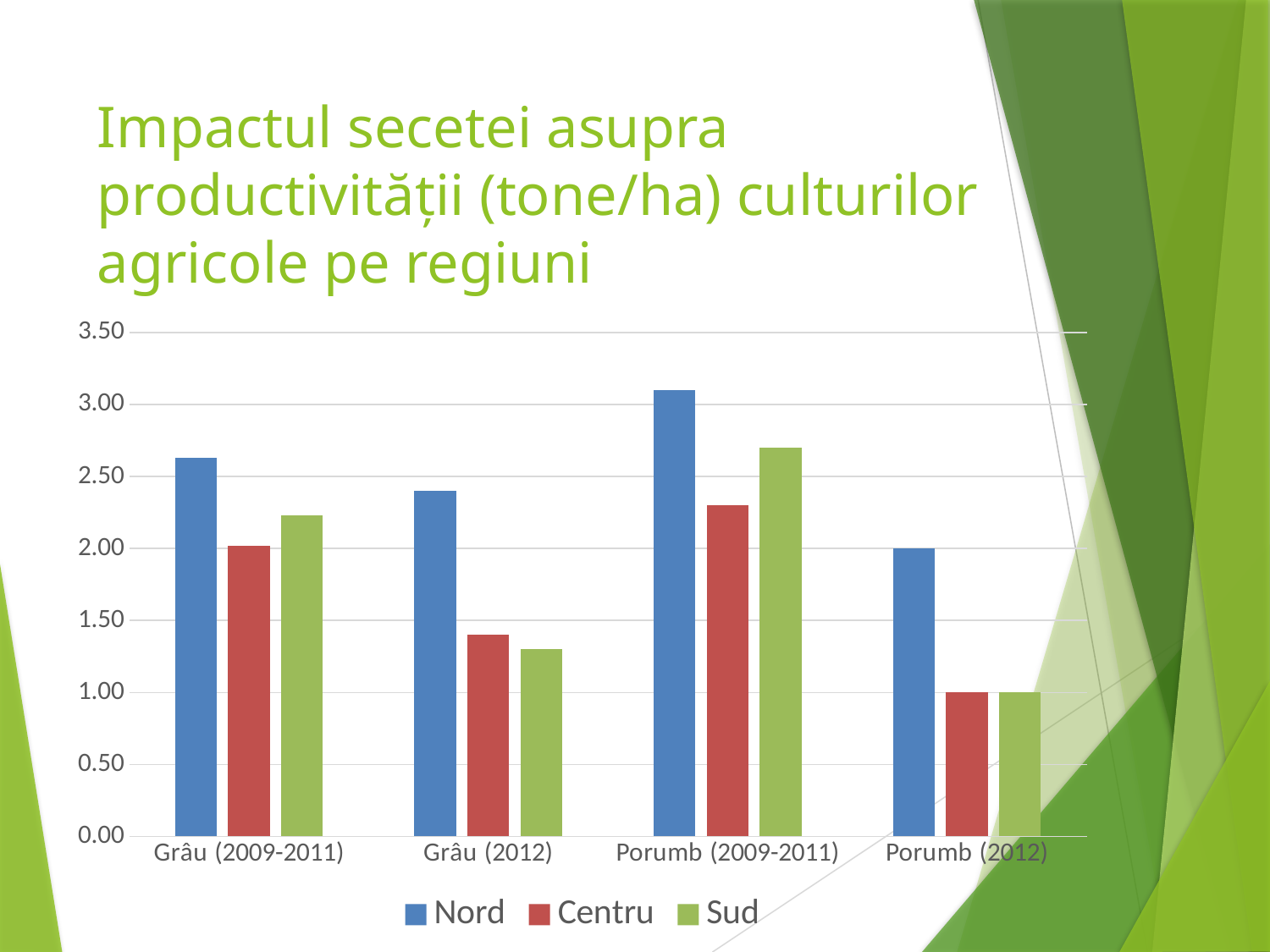
Which series has the highest value for Porumb (2009-2011)? Nord Which series has the lowest value for Grâu (2012)? Sud How many categories are shown on the x axis? 4 Is the value for Nord in Porumb (2009-2011) greater or less than 3.00? greater Which series is shown in red in the legend? Centru Is the value for Nord in Grâu (2009-2011) greater or less than 2.50? greater Is the value for Centru in Grâu (2012) greater or less than 1.50? less What kind of chart is shown on the slide? bar chart Which is larger for Grâu (2009-2011): the value for Centru or the value for Sud? Sud How many series does the legend list? 3 Does the value for Nord rise or fall from Grâu (2009-2011) to Grâu (2012)? fall